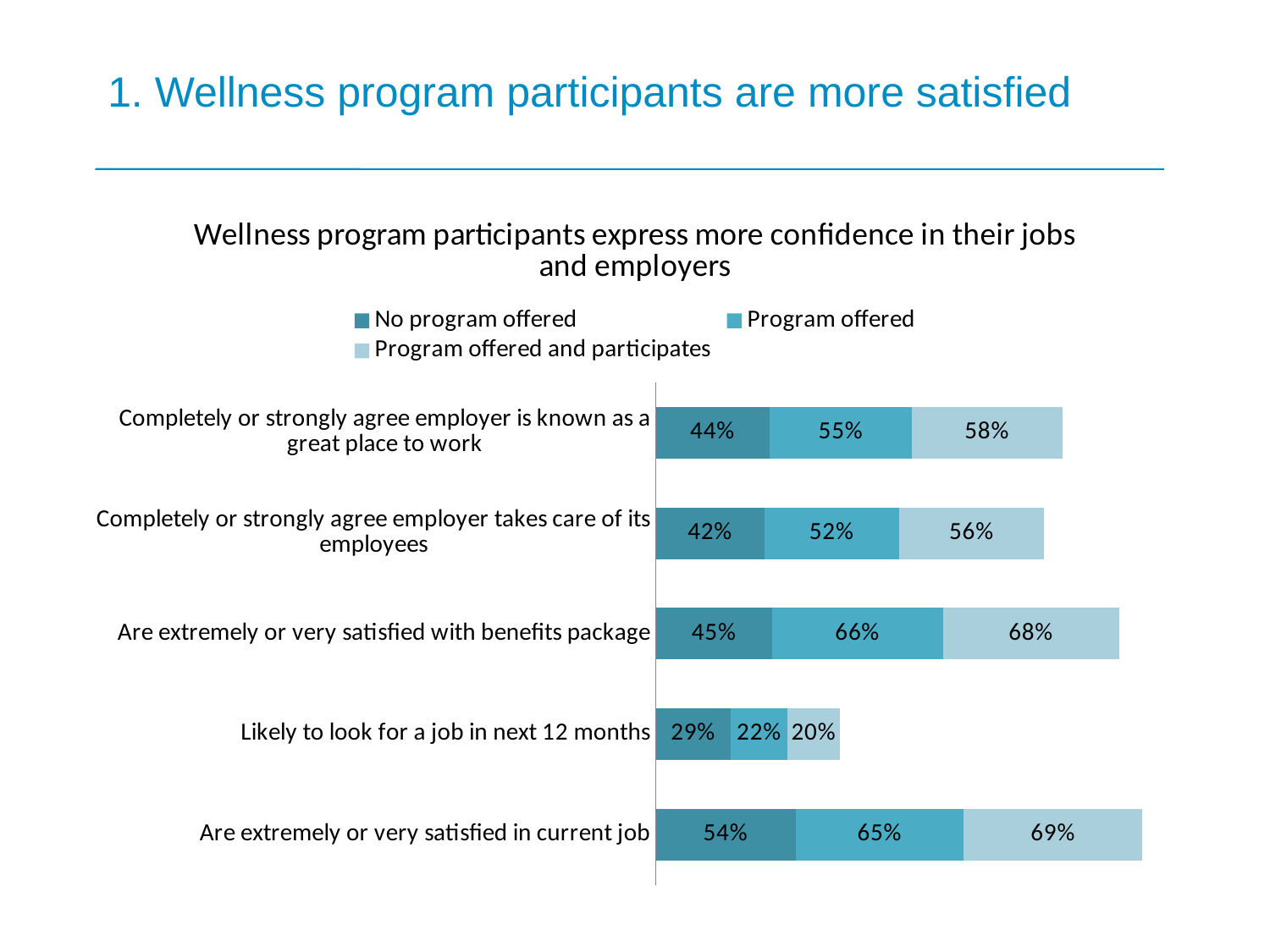
What is the title of the chart? Wellness program participants express more confidence in their jobs and employers For "Likely to look for a job in next 12 months", which is larger: "No program offered" or "Program offered and participates"? No program offered How many series does the legend list? 3 Which category has the lowest value for "No program offered"? Likely to look for a job in next 12 months What is the value for "Program offered and participates" in the "Are extremely or very satisfied with benefits package" category? 68% Which category has the highest value for "Program offered and participates"? Are extremely or very satisfied in current job What is the difference between "Program offered and participates" and "No program offered" for "Are extremely or very satisfied with benefits package"? 23% What is the total of the stacked bar for "Are extremely or very satisfied in current job"? 188% How many categories are shown on the chart? 5 What is the value for "Program offered" in the "Completely or strongly agree employer takes care of its employees" category? 52% What kind of chart is shown on the slide? Bar chart What is the value for "No program offered" in the "Likely to look for a job in next 12 months" category? 29%